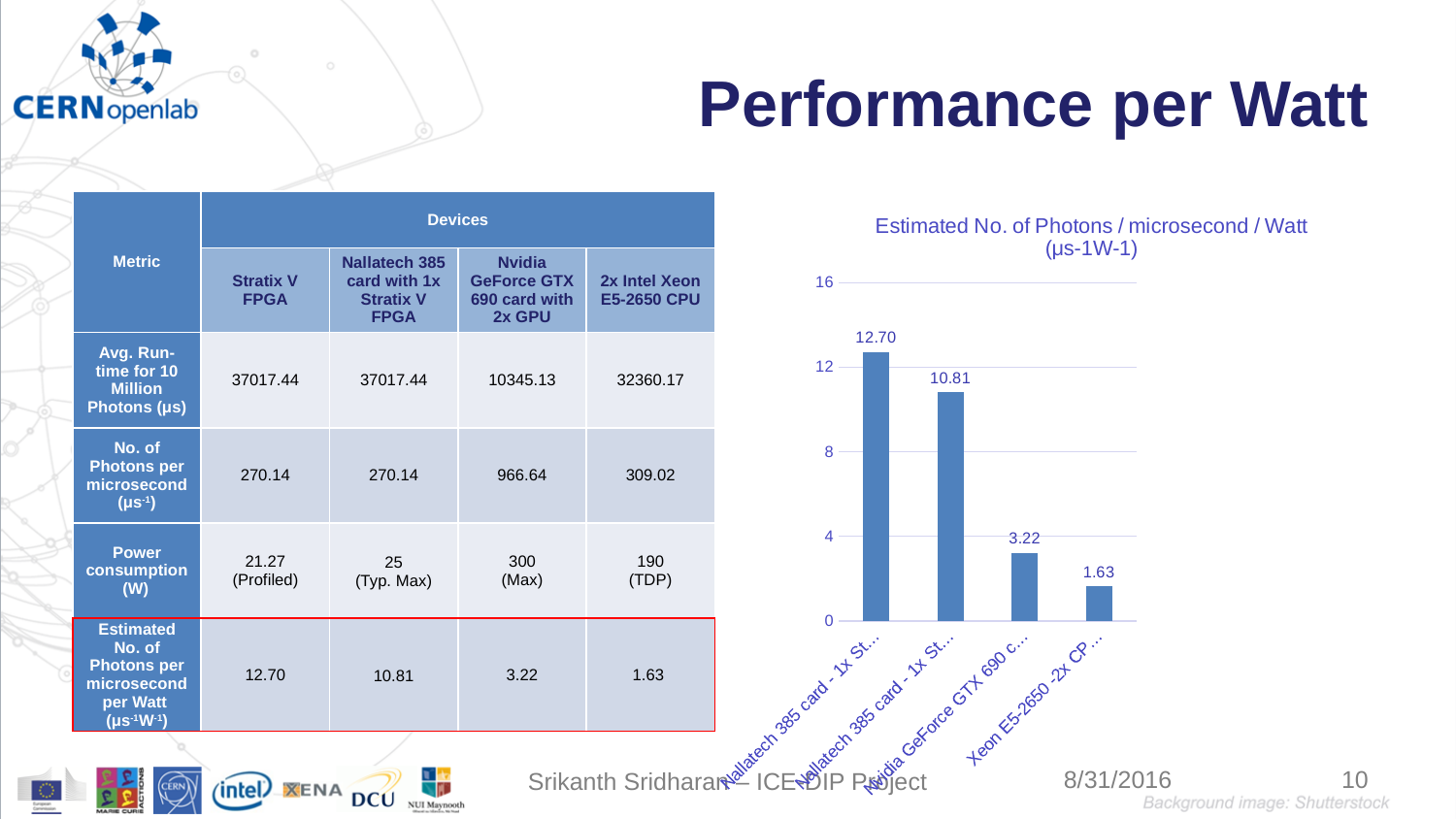
Which is larger, the value for Nvidia GeForce GTX 690 or the value for Xeon E5-2650? Nvidia GeForce GTX 690 What is the title of the chart? Estimated No. of Photons / microsecond / Watt (µs-1W-1) Which bar has the lowest value in the chart? Xeon E5-2650 What type of chart is shown on the slide? bar chart What is the highest value shown in the chart? 12.70 What is the value of the bar for Xeon E5-2650? 1.63 What is the value of the bar for Nvidia GeForce GTX 690? 3.22 What is the difference between the Nvidia GeForce GTX 690 bar and the Xeon E5-2650 bar? 1.59 Do the bar values rise or fall from left to right across the chart? fall What is the value of the first (leftmost) bar in the chart? 12.70 How many bars are plotted in the chart? 4 What is the value of the second bar from the left in the chart? 10.81